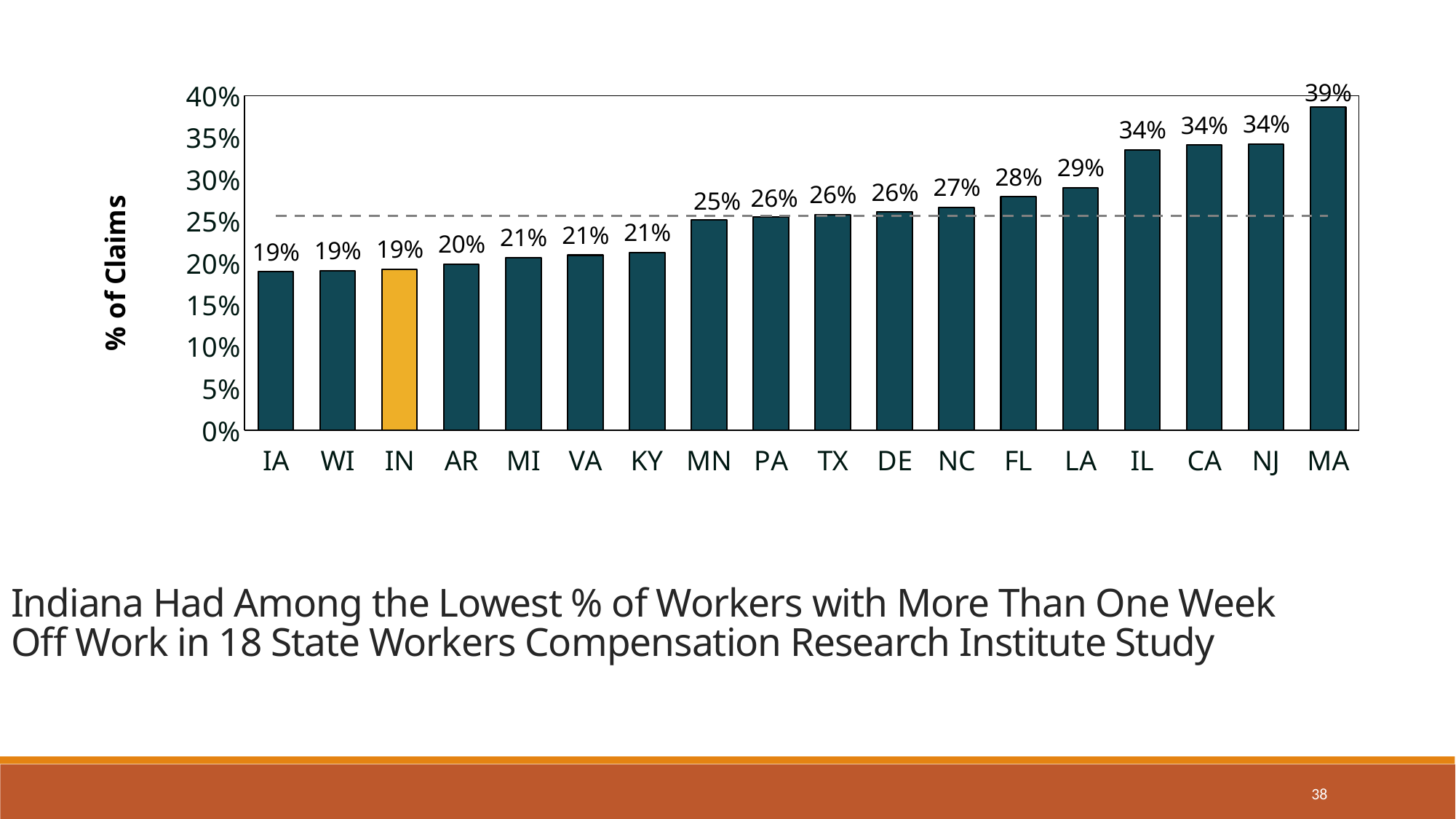
How many states are shown on the x axis? 18 What is the difference between the values for MA and IN? 20% What is the value for MN? 25% Is the value for KY greater or less than 25%? less What is the value for FL? 28% What is the value for MA? 39% Which state has the highest value? MA What is the value for IN? 19% Which bar is highlighted in a different colour (gold) from the others? IN Which is larger, the value for IL or the value for NC? IL What kind of chart is this? bar chart What is the difference between the values for LA and AR? 9%